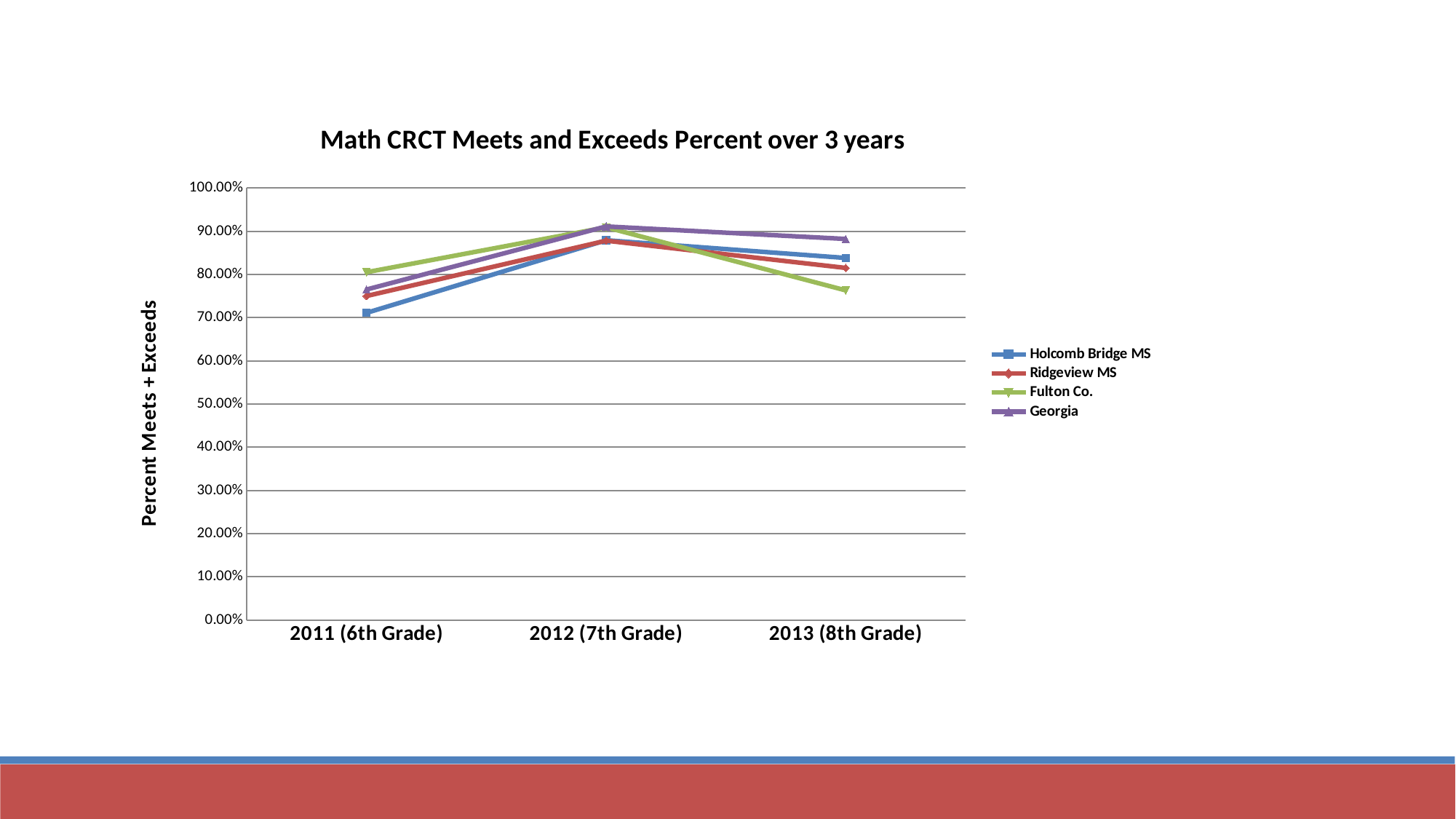
Is the value for Holcomb Bridge MS in 2011 (6th Grade) greater or less than 80.00%? less Does the Fulton Co. line rise or fall from 2012 (7th Grade) to 2013 (8th Grade)? fall Which series has the highest value in 2013 (8th Grade)? Georgia Which series has the highest value in 2011 (6th Grade)? Fulton Co. In 2013 (8th Grade), which is higher: Holcomb Bridge MS or Fulton Co.? Holcomb Bridge MS Is the value for Fulton Co. in 2013 (8th Grade) greater or less than 80.00%? less What is the title of the y axis? Percent Meets + Exceeds How many series does the legend list? 4 How many categories are shown on the x axis? 3 Which series has the lowest value in 2011 (6th Grade)? Holcomb Bridge MS What kind of chart is shown on the slide? line chart Is the value for Georgia in 2013 (8th Grade) greater or less than 80.00%? greater